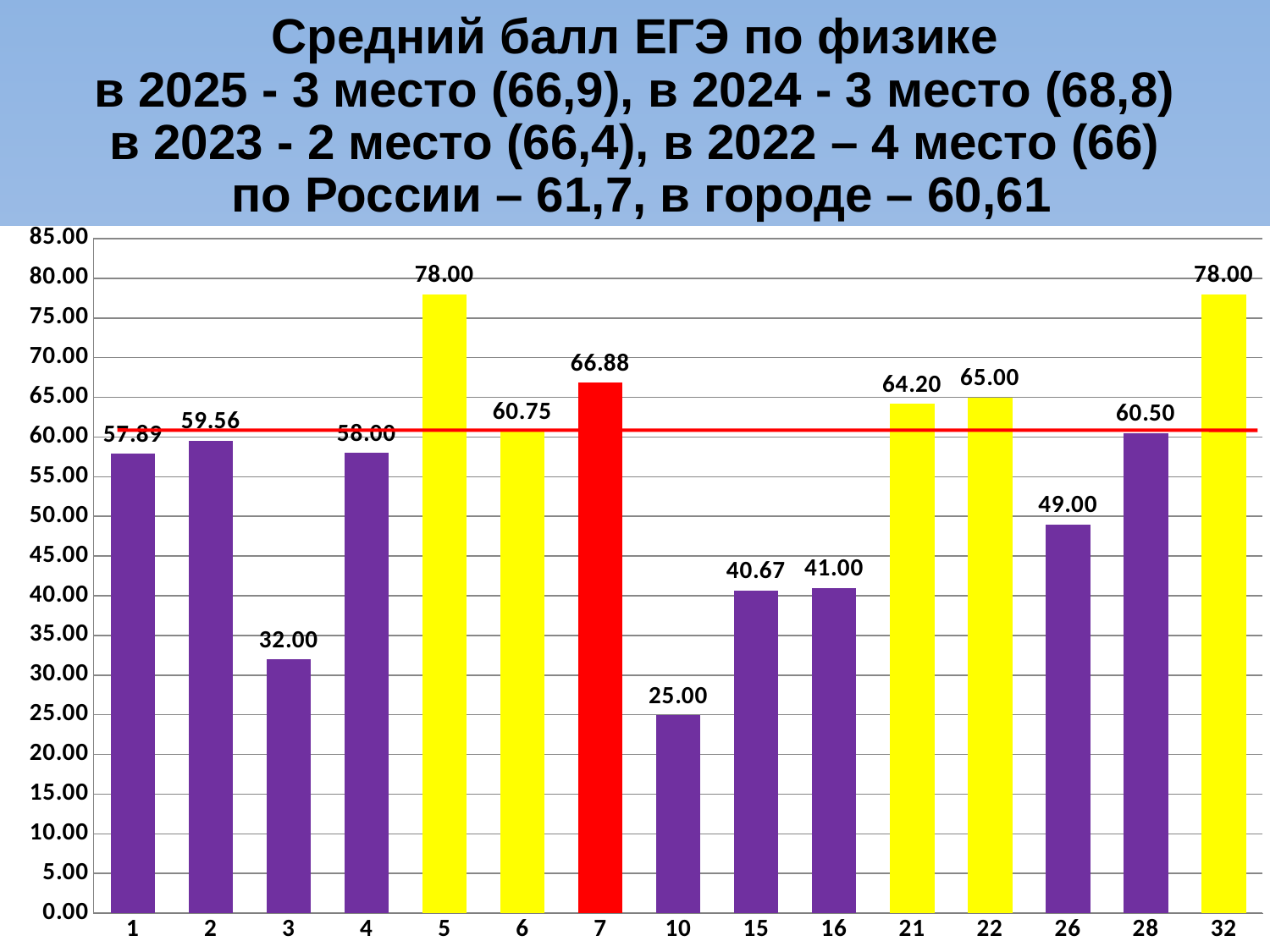
What is the value for category 10? 25.00 Which has a larger value, category 3 or category 15? category 15 What type of chart is shown on the slide? bar chart How many bars (categories) are plotted in the chart? 15 What is the value for category 7? 66.88 What is the difference between the values for category 22 and category 26? 16.00 Is the value for category 28 greater or less than 55.00? greater What colour is the bar for category 7? red What is the difference between the values for category 5 and category 7? 11.12 What is the value for category 21? 64.20 What is the highest value shown in the chart? 78.00 Which category has the lowest value? 10